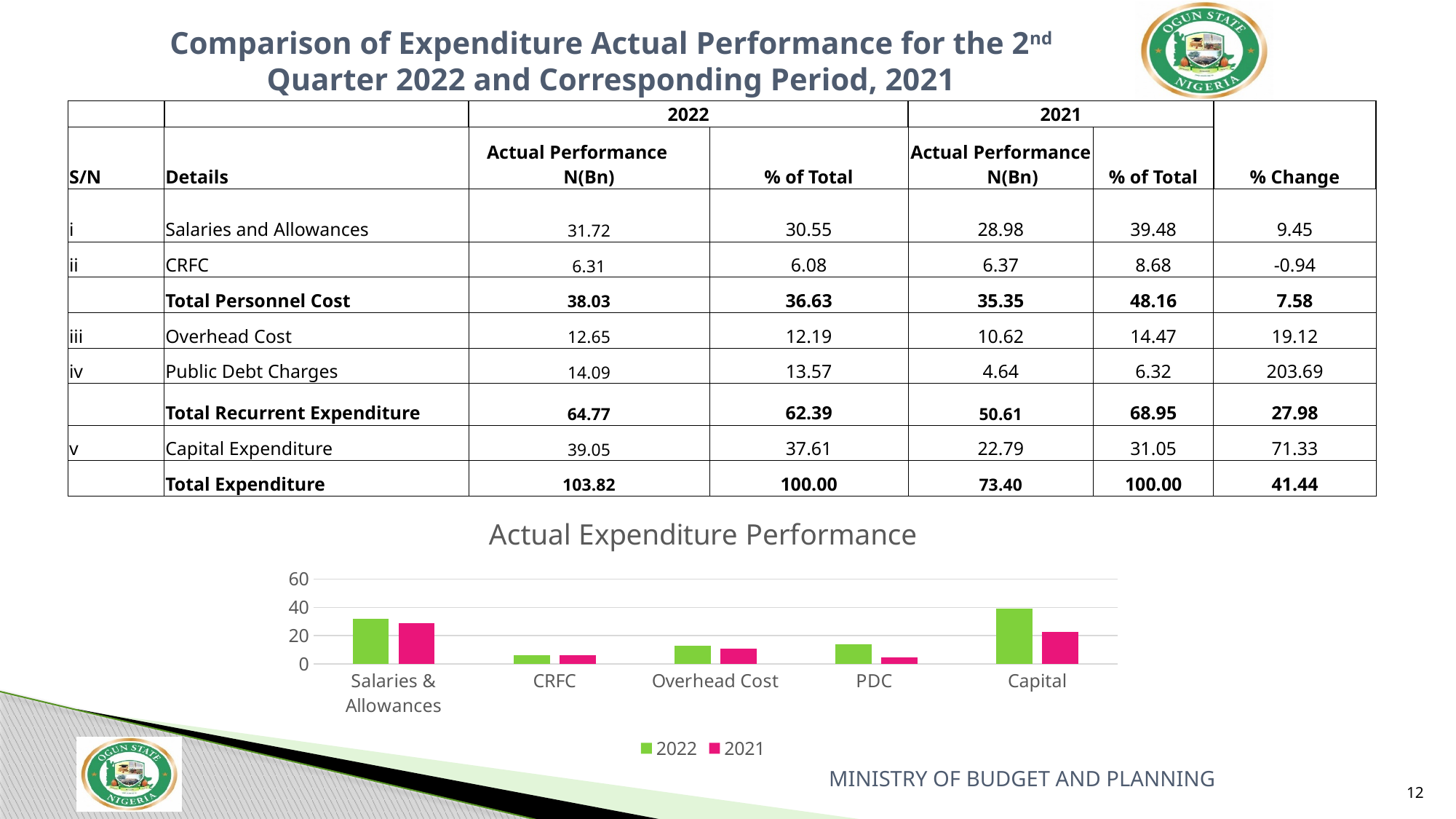
Which category has the highest 2022 bar in the "Actual Expenditure Performance" chart? Capital In the "Actual Expenditure Performance" chart, which is larger for PDC: the 2022 bar or the 2021 bar? 2022 Which category has the highest 2021 bar in the "Actual Expenditure Performance" chart? Salaries & Allowances Which category has the lowest 2021 bar in the "Actual Expenditure Performance" chart? PDC In the "Actual Expenditure Performance" chart, is the 2022 value for Salaries & Allowances greater or less than 20? greater In the "Actual Expenditure Performance" chart, is the 2021 value for PDC greater or less than 20? less How many categories are shown on the x axis of the "Actual Expenditure Performance" chart? 5 Which category has the lowest 2022 bar in the "Actual Expenditure Performance" chart? CRFC In the "Actual Expenditure Performance" chart, is the 2022 bar for Capital larger or smaller than the 2021 bar for Capital? larger What kind of chart is shown under the title "Actual Expenditure Performance"? bar chart How many series does the legend of the "Actual Expenditure Performance" chart list? 2 Which colour represents the 2022 series in the "Actual Expenditure Performance" chart? green